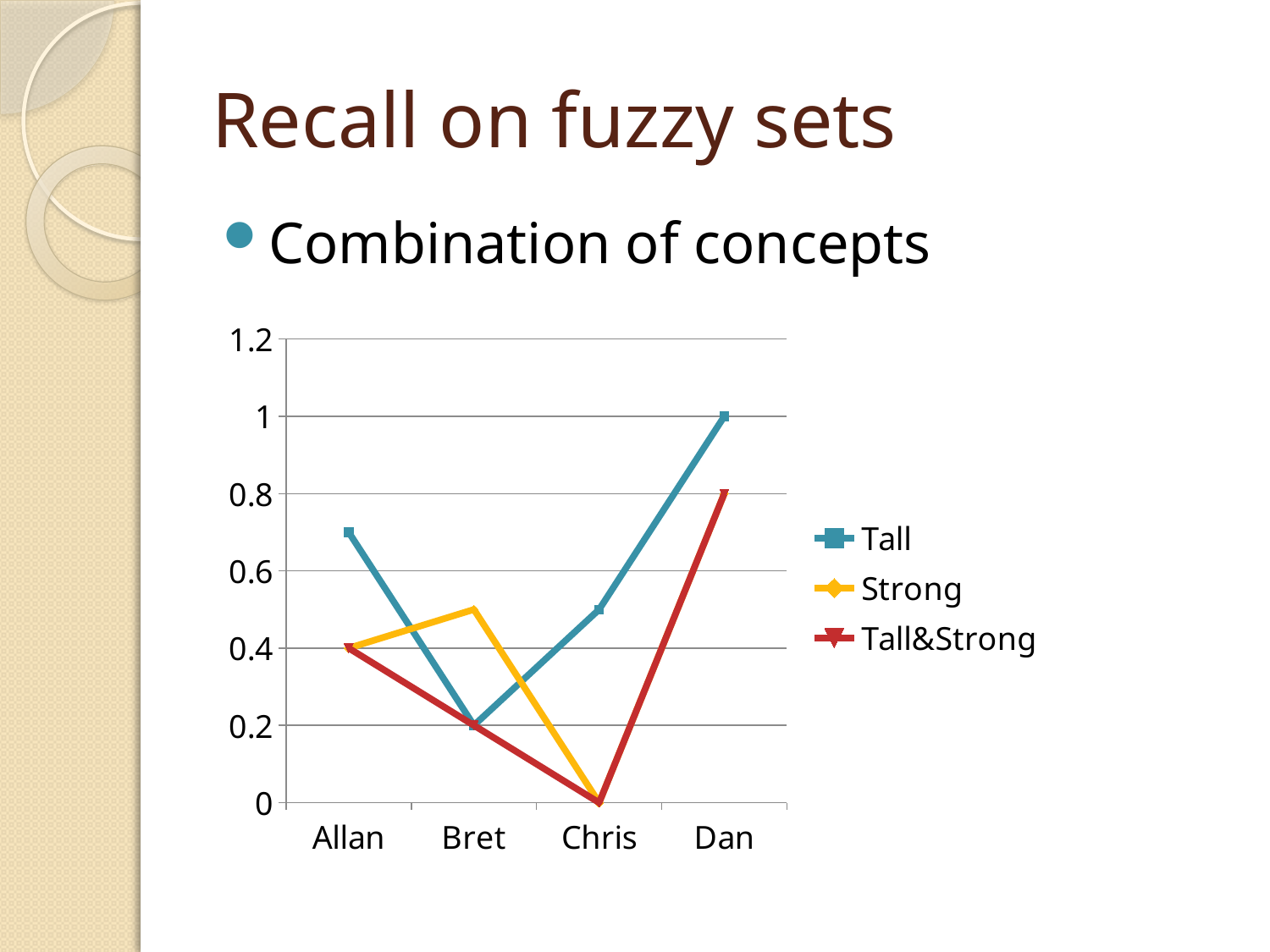
What is the Tall&Strong value for Chris? 0 Which person has the highest Tall value? Dan What is the Tall value for Dan? 1 What is the Tall&Strong value for Dan? 0.8 What kind of chart is shown on the slide? line chart What is the difference between the Tall&Strong value for Dan and the Tall&Strong value for Allan? 0.4 For Chris, which is larger: the Tall value or the Tall&Strong value? Tall How many categories are shown on the x axis? 4 Which person has the lowest Tall value? Bret What is the Tall value for Bret? 0.2 Is the Tall value for Allan greater or less than 0.6? greater How many series does the legend list? 3